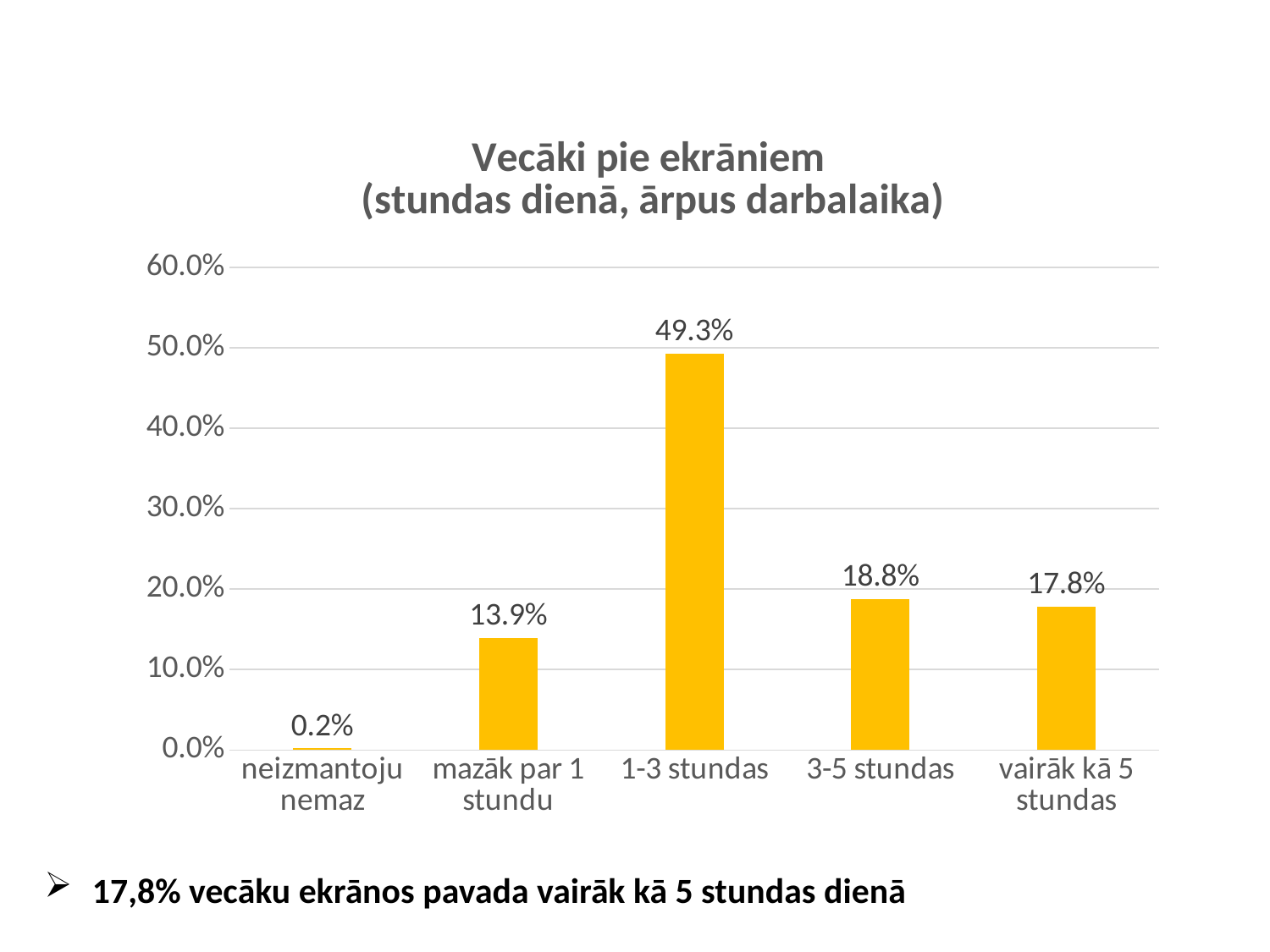
Is the value for "1-3 stundas" greater or less than 40.0%? greater What is the title of the chart? Vecāki pie ekrāniem (stundas dienā, ārpus darbalaika) Which category has the lowest value? neizmantoju nemaz What is the difference between the values for "1-3 stundas" and "3-5 stundas"? 30.5% What is the difference between the values for "3-5 stundas" and "vairāk kā 5 stundas"? 1.0% What is the value for "mazāk par 1 stundu"? 13.9% Which is larger, the value for "mazāk par 1 stundu" or the value for "3-5 stundas"? 3-5 stundas What is the value for "1-3 stundas"? 49.3% Which category has the highest value? 1-3 stundas What kind of chart is shown on the slide? bar chart How many categories are shown on the x axis? 5 What is the value for "vairāk kā 5 stundas"? 17.8%